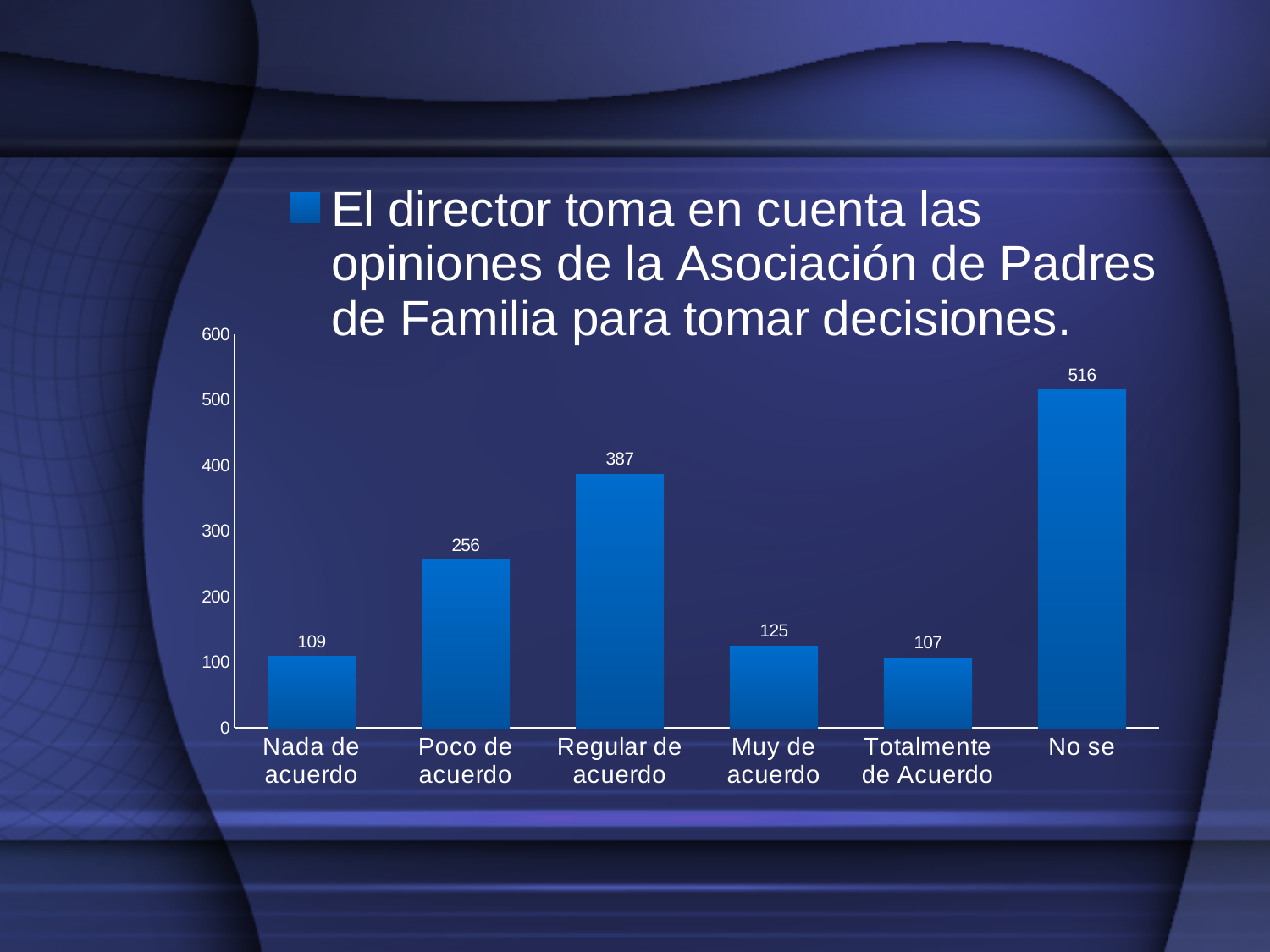
What is the value for "Totalmente de Acuerdo"? 107 How many categories are shown on the x axis? 6 Which is larger, the value for "Muy de acuerdo" or the value for "Nada de acuerdo"? Muy de acuerdo What is the value for "Regular de acuerdo"? 387 What is the difference between the values for "No se" and "Regular de acuerdo"? 129 Is the value for "Poco de acuerdo" greater or less than 300? less What is the maximum value shown on the vertical axis? 600 Which category has the lowest value? Totalmente de Acuerdo Which category has the highest value? No se What kind of chart is shown on the slide? bar chart What is the difference between the values for "Poco de acuerdo" and "Nada de acuerdo"? 147 What is the value for "No se"? 516